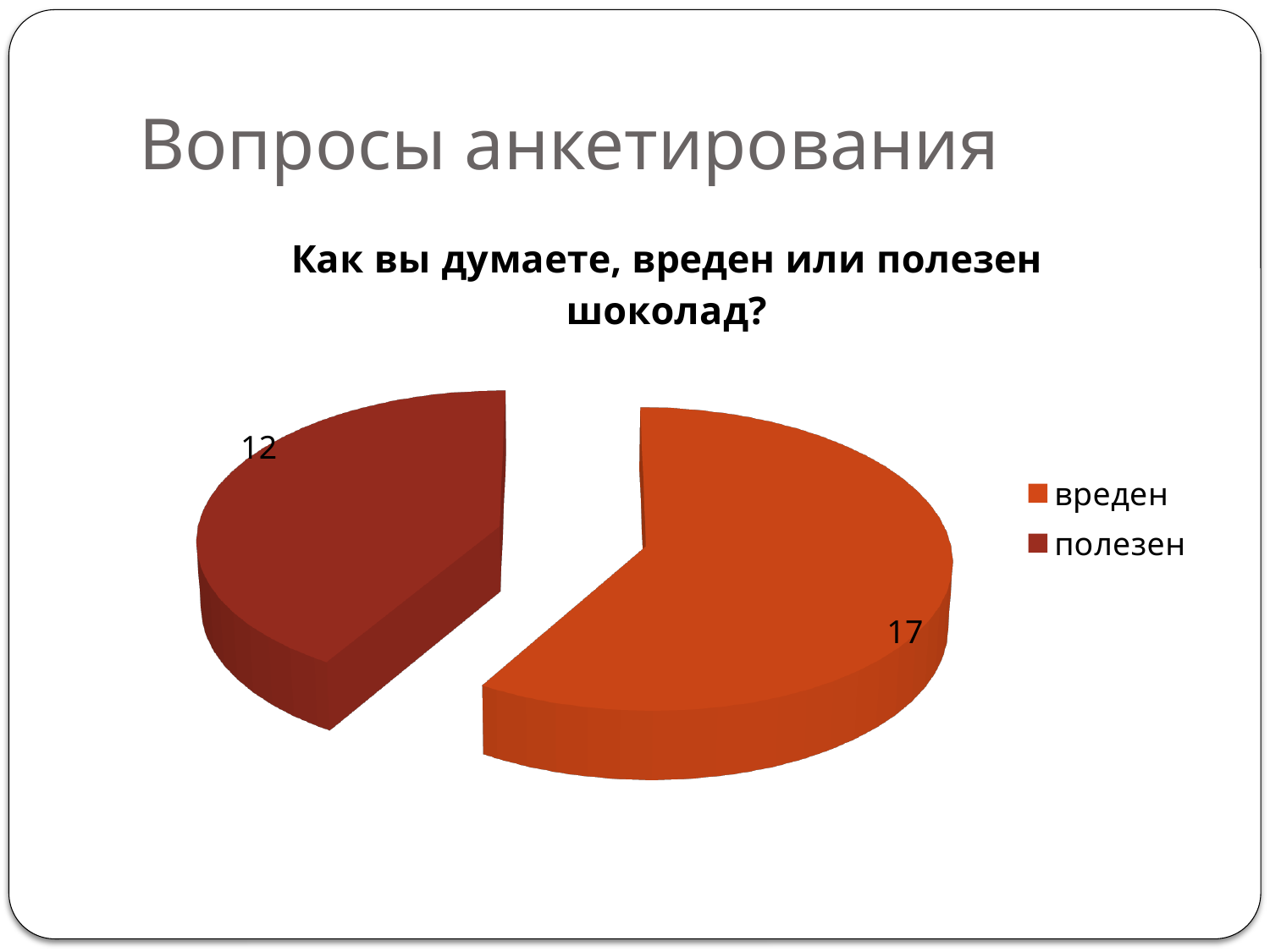
How many entries does the legend list? 2 What is the difference between the values for "вреден" and "полезен"? 5 How many slices does the pie chart have? 2 What value is shown for the "полезен" slice? 12 Which is larger, the value for "вреден" or for "полезен"? вреден What kind of chart is shown on the slide? pie chart What value is shown for the "вреден" slice? 17 Which legend entry is shown in the darker red colour? полезен What is the total of the two slice values? 29 Which category has the largest slice? вреден What is the title of the chart? Как вы думаете, вреден или полезен шоколад? Which category has the smallest slice? полезен